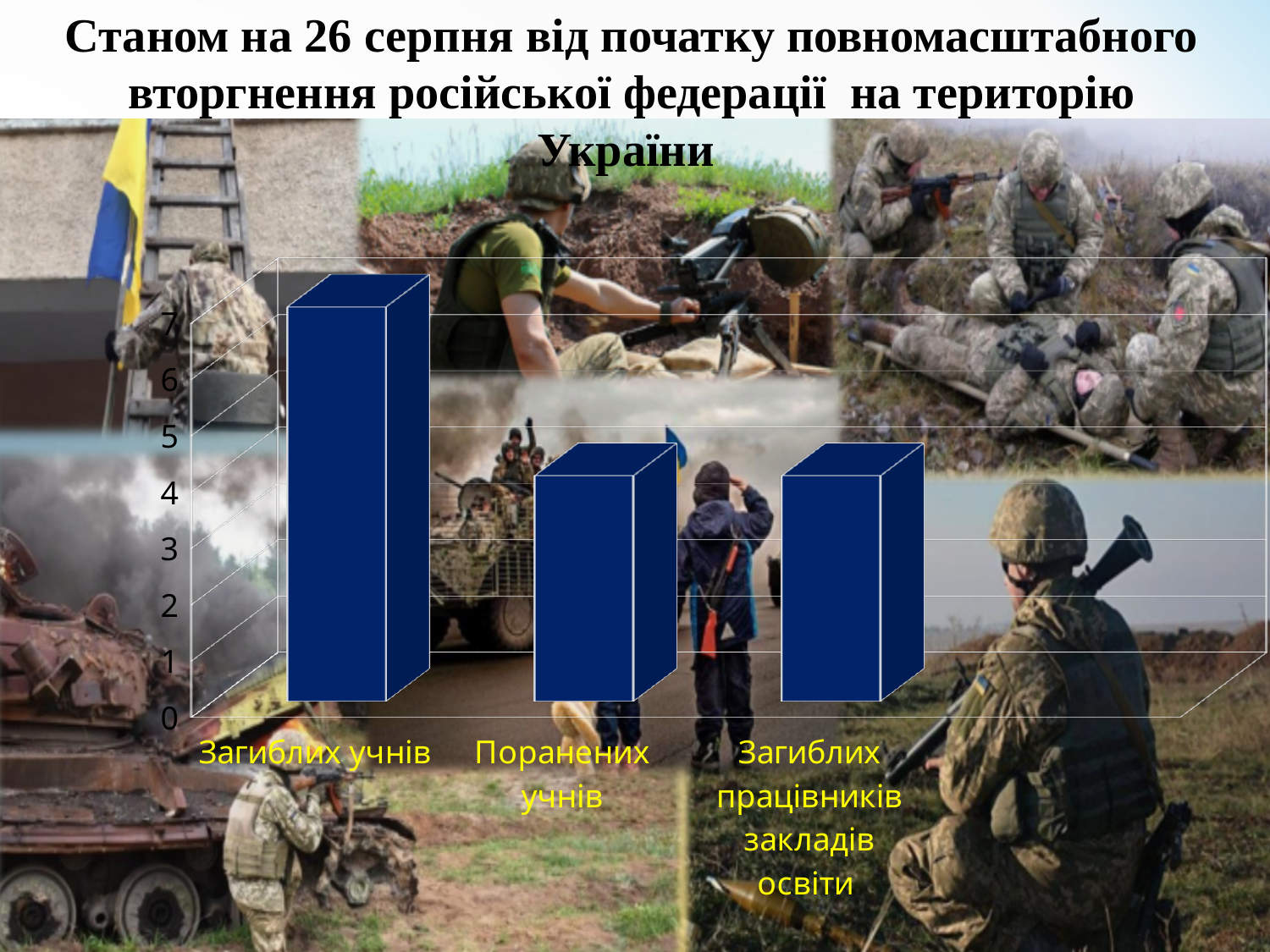
Is the value for Загиблих працівників закладів освіти greater or less than 6? less What is the highest tick value shown on the vertical axis of the chart? 7 How many categories are shown on the x axis of the chart? 3 What kind of chart is shown on the slide? bar chart What colour are the bars in the chart? dark blue Is the value for Загиблих учнів greater or less than 5? greater Which category has the highest bar in the chart? Загиблих учнів Which is larger: the value for Загиблих учнів or the value for Поранених учнів? Загиблих учнів Which is larger: the value for Загиблих учнів or the value for Загиблих працівників закладів освіти? Загиблих учнів Is the value for Поранених учнів greater or less than 6? less